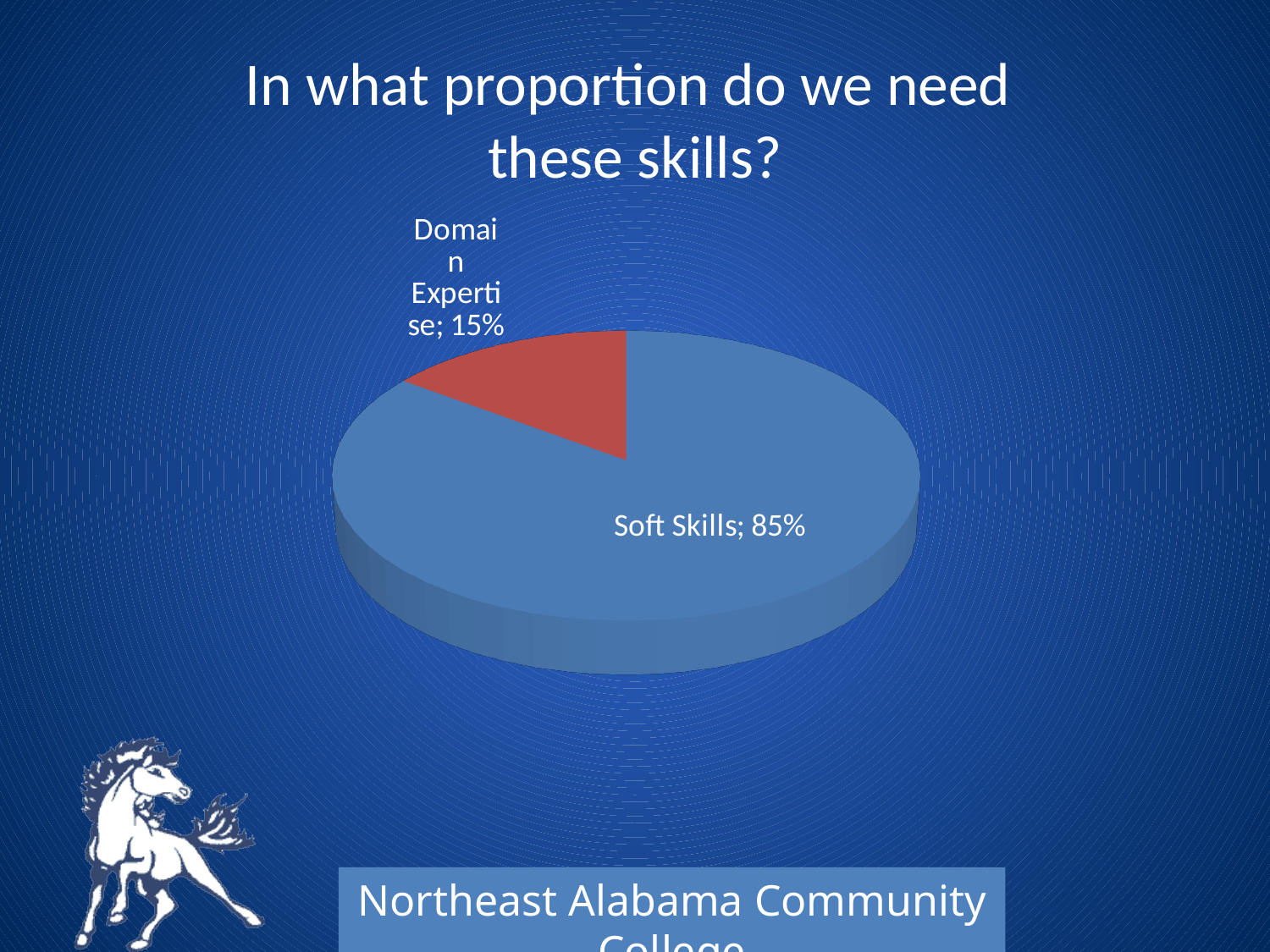
How many slices does the pie chart have? 2 What is the difference in percentage points between Soft Skills and Domain Expertise? 70 What colour is the Domain Expertise slice? Red What share of the pie is Soft Skills? 85% Which slice of the pie is the largest? Soft Skills What is the title of the slide containing the pie chart? In what proportion do we need these skills? What kind of chart is shown on the slide? Pie chart What share of the pie is Domain Expertise? 15% Which is larger, the Soft Skills slice or the Domain Expertise slice? Soft Skills Which slice of the pie is the smallest? Domain Expertise